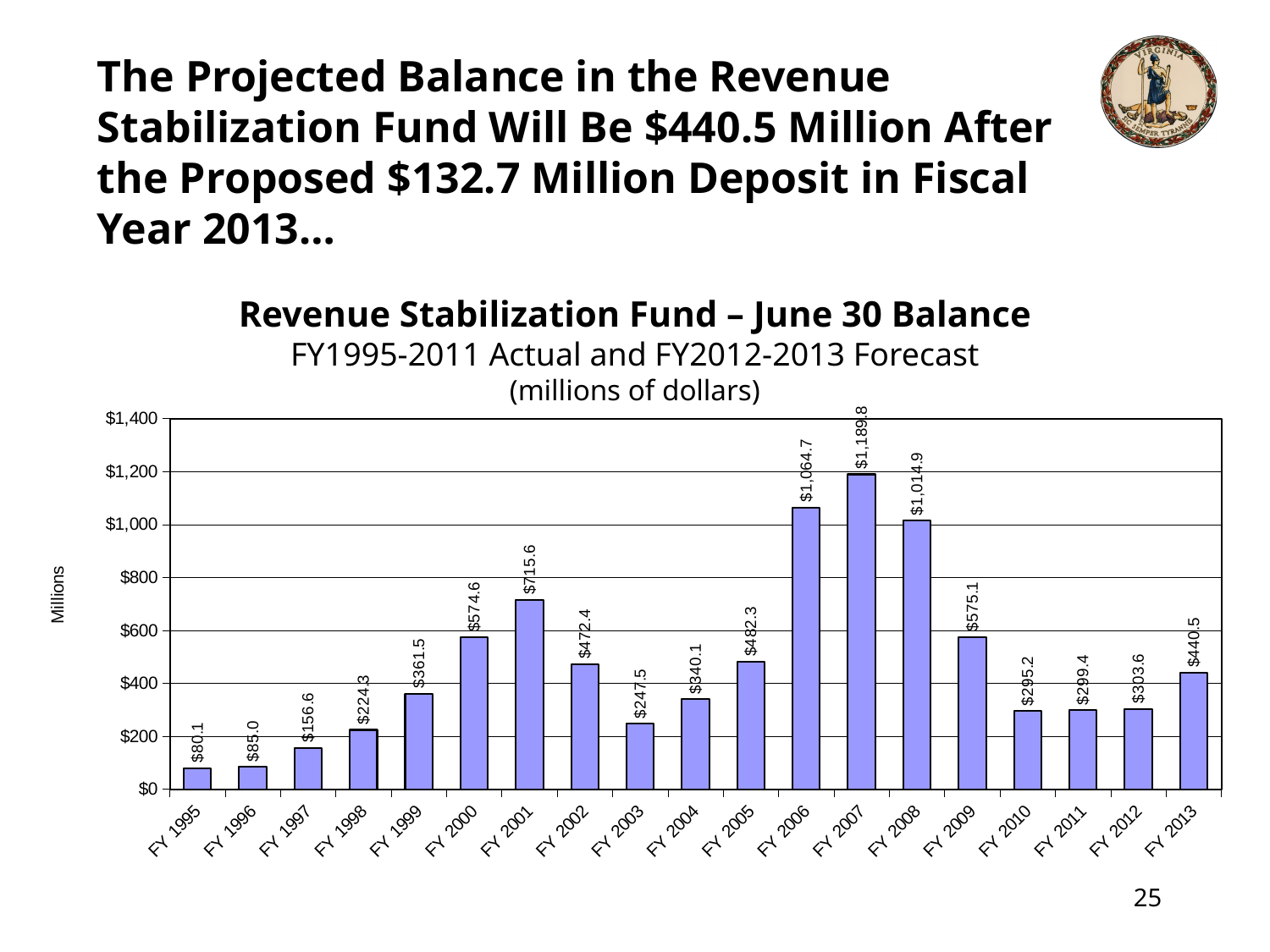
What kind of chart is shown on the slide? Bar chart Which is larger, the balance for FY 2000 or the balance for FY 2009? FY 2009 What is the Revenue Stabilization Fund balance for FY 2013? $440.5 Which fiscal year has the highest June 30 balance? FY 2007 What is the difference between the FY 2007 balance and the FY 2008 balance? $174.9 What is the title of the chart? Revenue Stabilization Fund – June 30 Balance What is the Revenue Stabilization Fund balance for FY 2001? $715.6 Which fiscal year has the lowest June 30 balance? FY 1995 Is the value for FY 2006 greater or less than $1,000? greater What is the Revenue Stabilization Fund balance for FY 2007? $1,189.8 How many fiscal years are shown on the x axis? 19